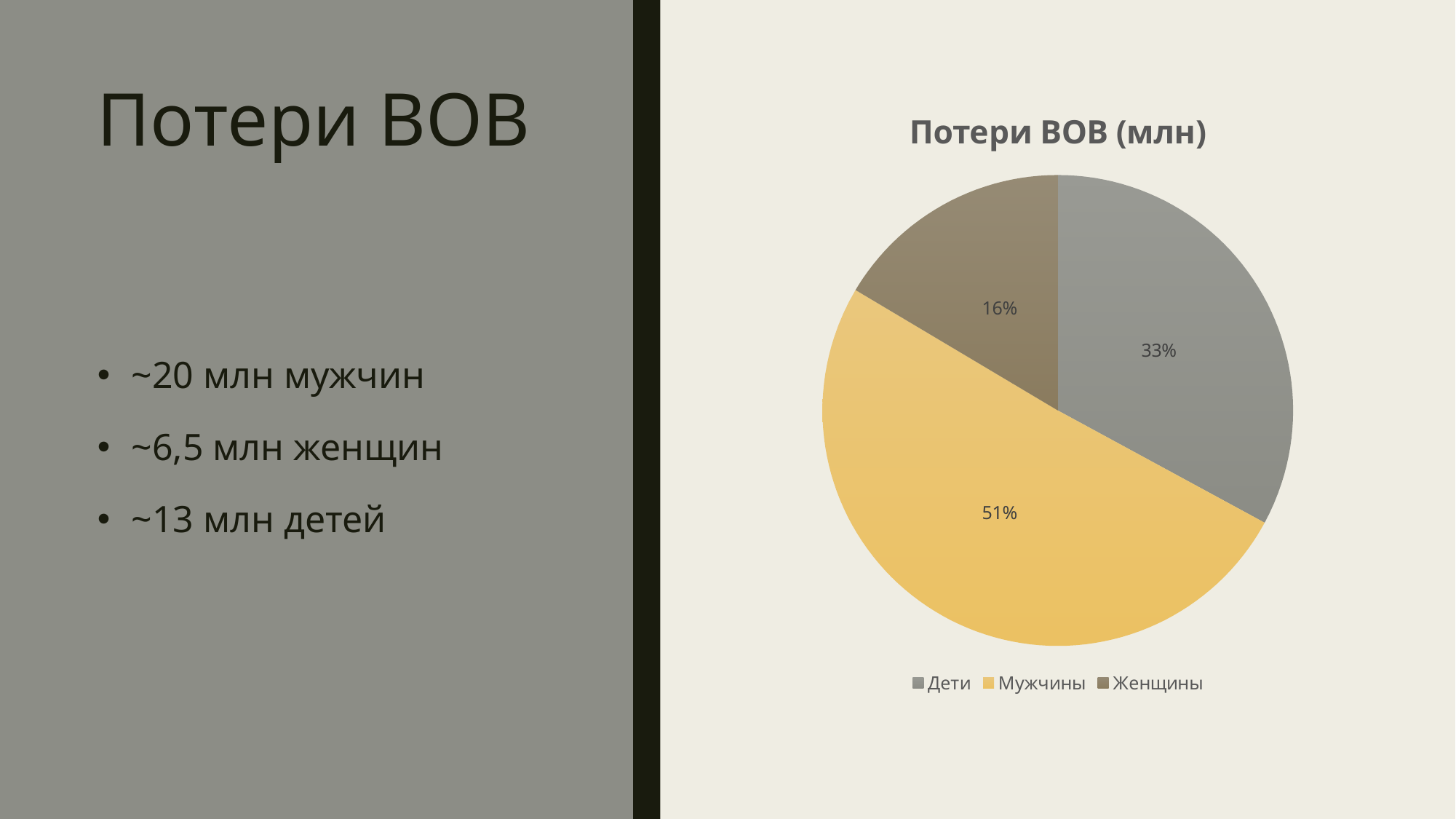
What is the title of the chart? Потери ВОВ (млн) Which category has the smallest slice of the pie? Женщины What is the difference in percentage points between the Мужчины slice and the Дети slice? 18% What share of the pie does Дети take? 33% What share of the pie does Мужчины take? 51% What type of chart is shown on the slide? pie chart Which category has the largest slice of the pie? Мужчины What share of the pie does Женщины take? 16% How many entries does the legend list? 3 Which slice is larger, Дети or Женщины? Дети Which category is shown in yellow in the pie chart? Мужчины How many slices does the pie chart have? 3